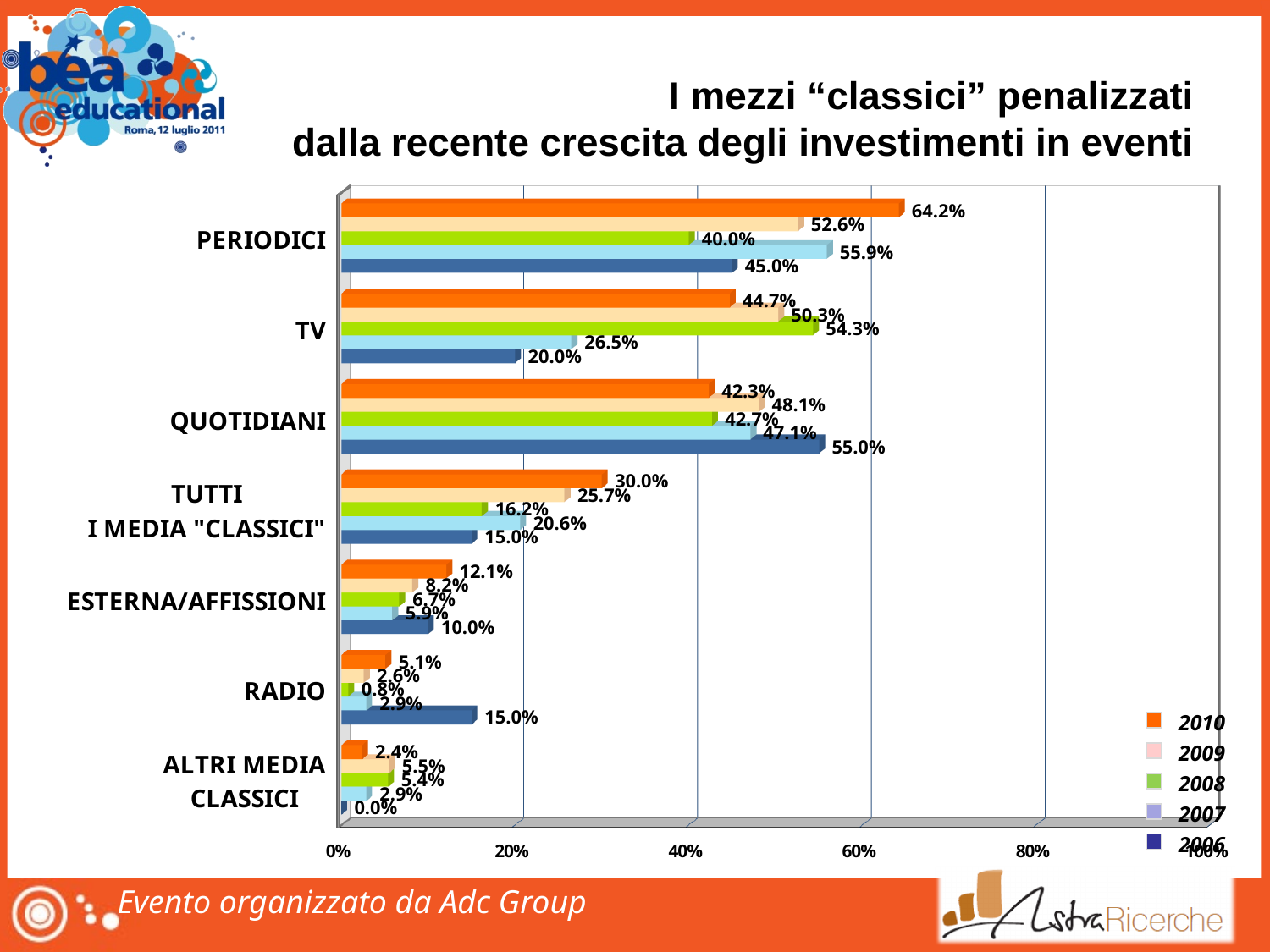
Which category has the lowest value in 2006? ALTRI MEDIA CLASSICI Which colour represents the 2010 series in the legend? Orange How many series does the legend list? 5 What is the value for TV in 2006? 20.0% How many categories are shown on the chart? 7 What kind of chart is shown on the slide? Bar chart What is the difference between the 2010 and 2006 values for PERIODICI? 19.2% What is the value for QUOTIDIANI in 2006? 55.0% What is the value for RADIO in 2006? 15.0% Which is larger for TV: the 2008 value or the 2010 value? 2008 Which category has the highest value in 2010? PERIODICI What is the value for PERIODICI in 2010? 64.2%